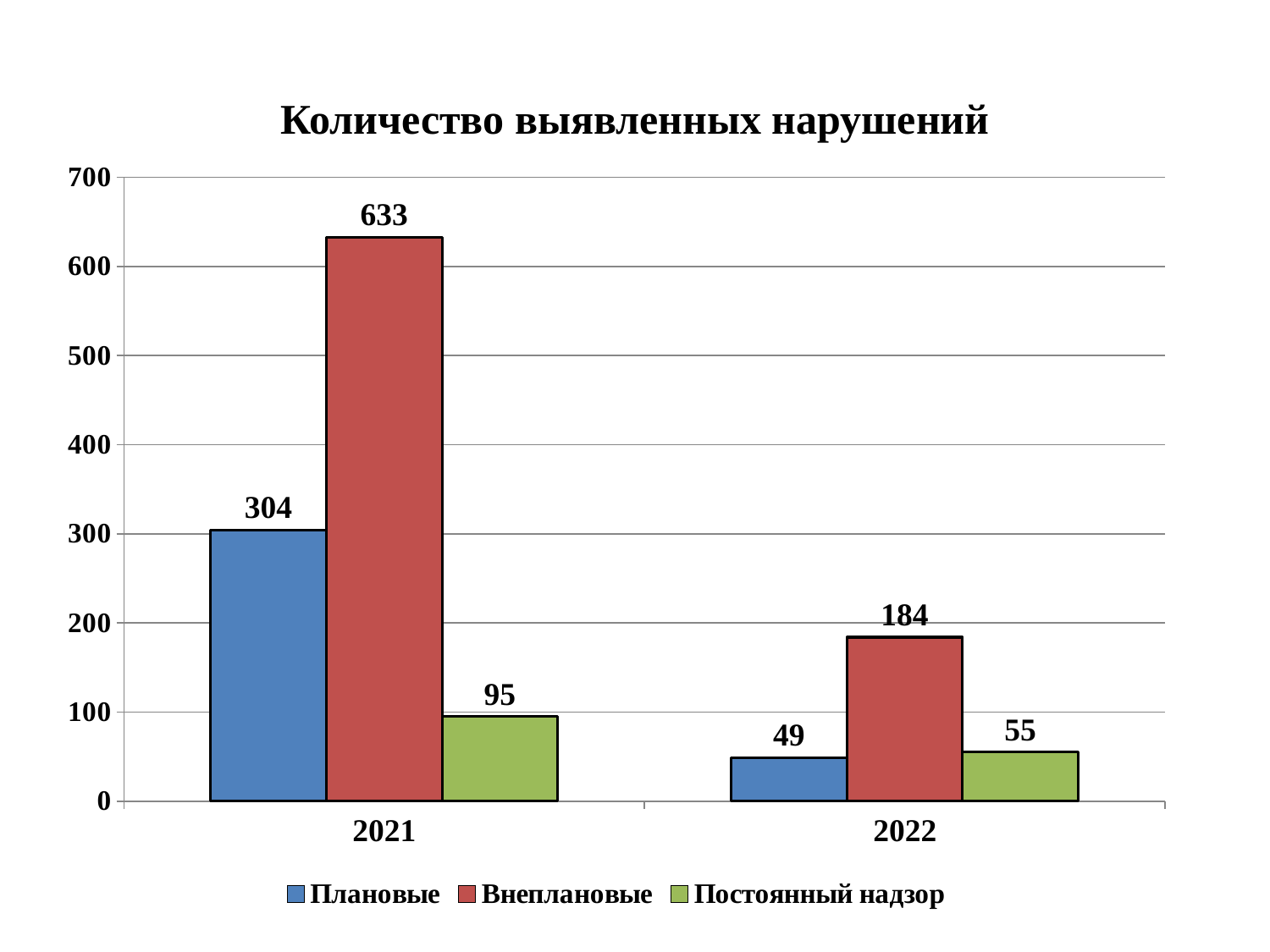
How many series does the legend list? 3 Which is larger: Плановые in 2021 or Внеплановые in 2022? Плановые in 2021 Which series has the highest value in 2021? Внеплановые What is the value for Плановые in 2022? 49 What is the value for Постоянный надзор in 2021? 95 Which series has the lowest value in 2022? Плановые What is the title of the chart? Количество выявленных нарушений What kind of chart is shown? bar chart What is the value for Внеплановые in 2021? 633 Is the value for Постоянный надзор in 2022 greater or less than 100? less How many categories are shown on the x axis? 2 What is the difference between the Внеплановые values for 2021 and 2022? 449